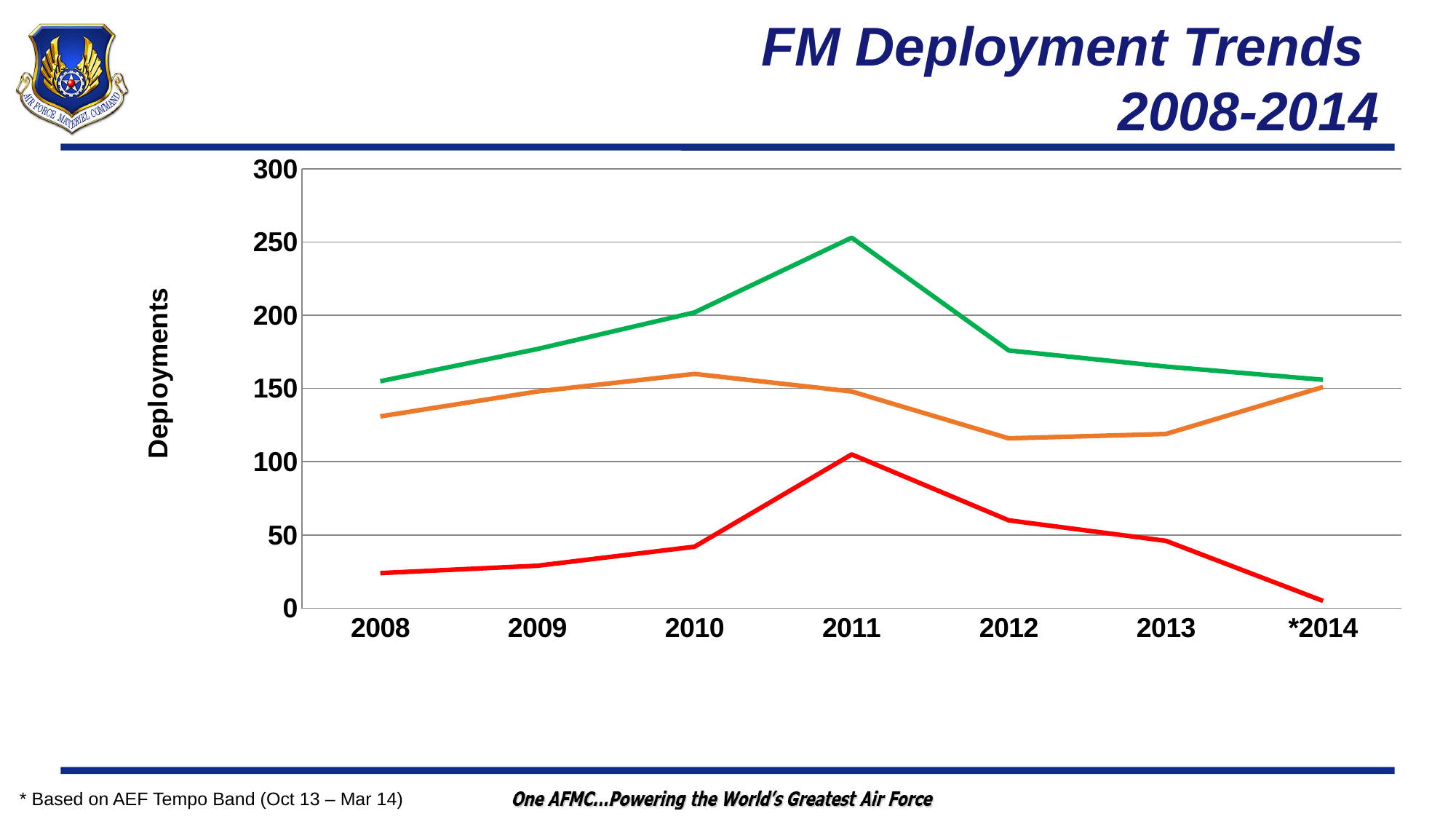
In 2011, which line has the higher value, the green line or the orange line? green line Is the value of the red line in 2011 greater or less than 50? greater In which year does the red line reach its lowest value? *2014 Is the value of the red line in *2014 greater or less than 50? less Does the red line rise or fall from 2011 to *2014? fall What kind of chart is shown on the slide? line chart In which year does the green line reach its highest value? 2011 Is the value of the orange line in 2012 greater or less than 150? less How many lines are plotted on the chart? 3 In which year does the red line reach its highest value? 2011 How many years are shown along the x axis of the chart? 7